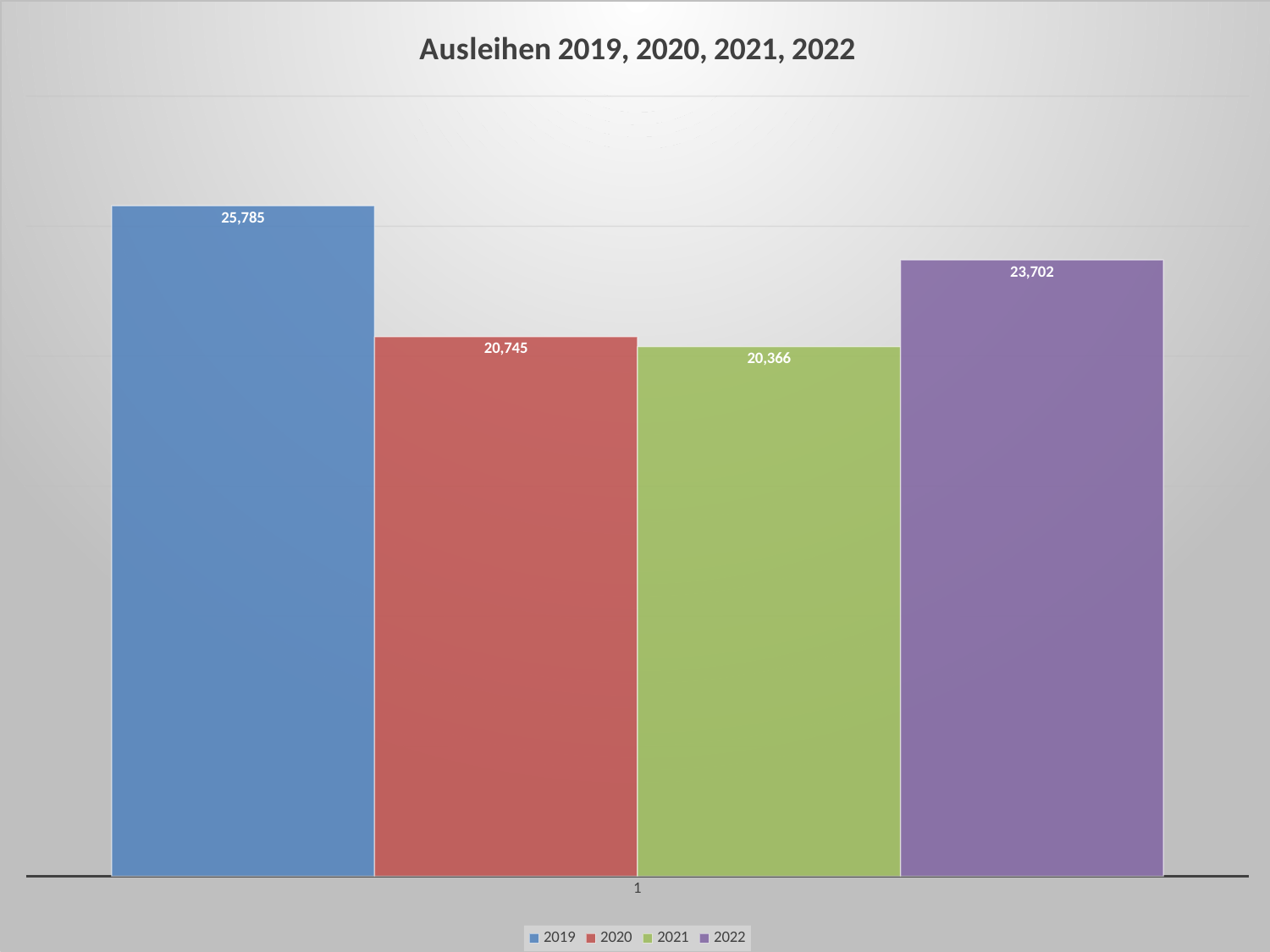
What is the difference between the values for 2022 and 2021? 3,336 What is the value for 2019? 25,785 What is the value for 2022? 23,702 Which year has the lowest value? 2021 Which year has the highest value? 2019 What is the value for 2021? 20,366 How many series does the legend list? 4 What is the difference between the values for 2019 and 2020? 5,040 What is the title of the chart? Ausleihen 2019, 2020, 2021, 2022 What colour is the bar for 2022? purple Which is larger, the value for 2020 or the value for 2022? 2022 What kind of chart is shown? bar chart